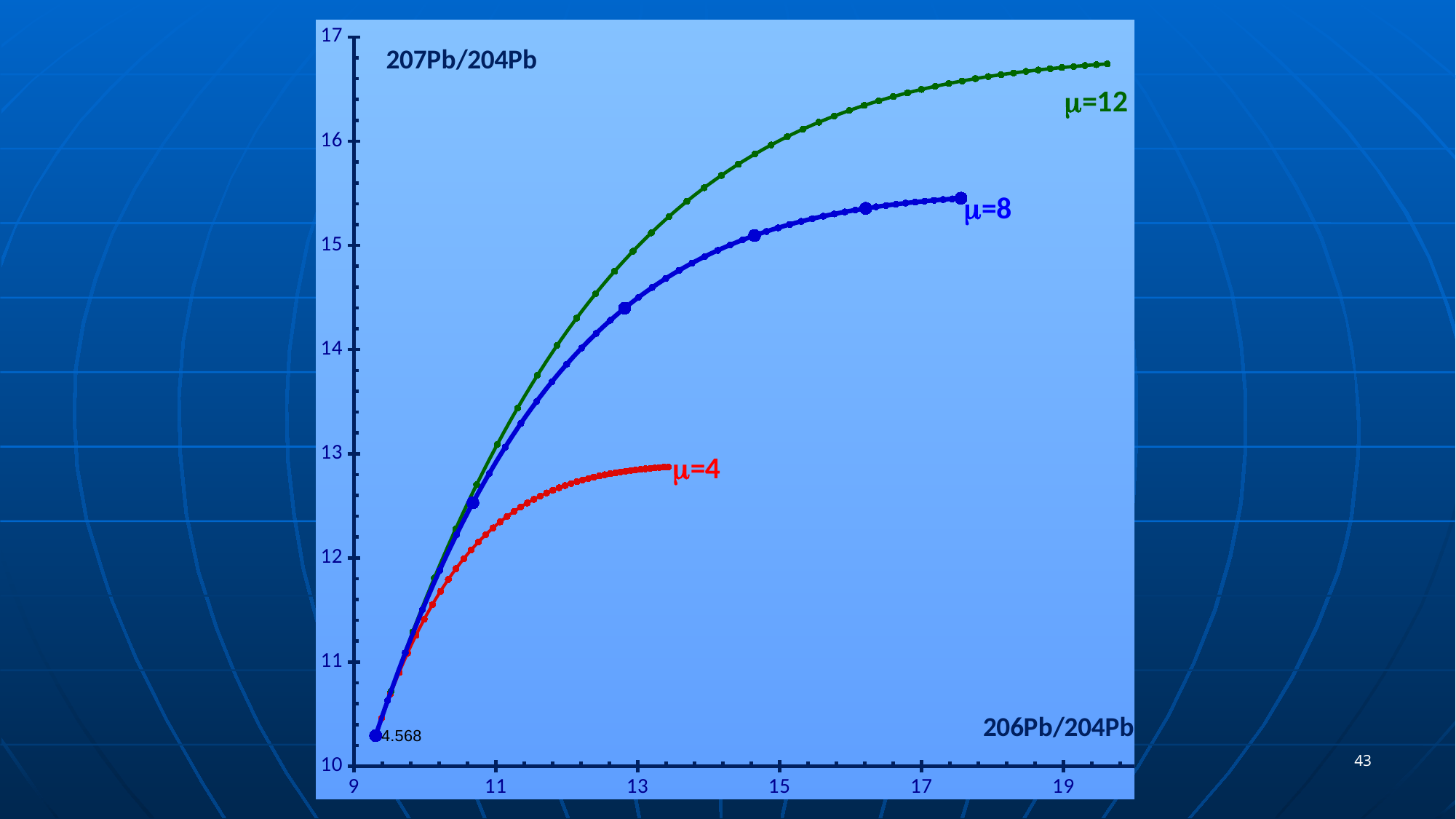
Is the highest 207Pb/204Pb value reached by the μ=12 curve greater or less than 16? greater Does the 207Pb/204Pb value rise or fall as 206Pb/204Pb increases along each curve? rise What kind of chart is shown on the slide? line chart Which curve extends further along the 206Pb/204Pb axis, μ=8 or μ=12? μ=12 What data label is printed next to the starting point of the curves at the bottom left? 4.568 Which curve reaches the highest 207Pb/204Pb value? μ=12 Is the highest 207Pb/204Pb value reached by the μ=8 curve greater or less than 15? greater What is the label of the vertical axis? 207Pb/204Pb How many curves (series) are plotted on the chart? 3 Which curve reaches the lowest maximum 207Pb/204Pb value? μ=4 Is the highest 207Pb/204Pb value reached by the μ=4 curve greater or less than 13? less What colour is the μ=4 curve? red